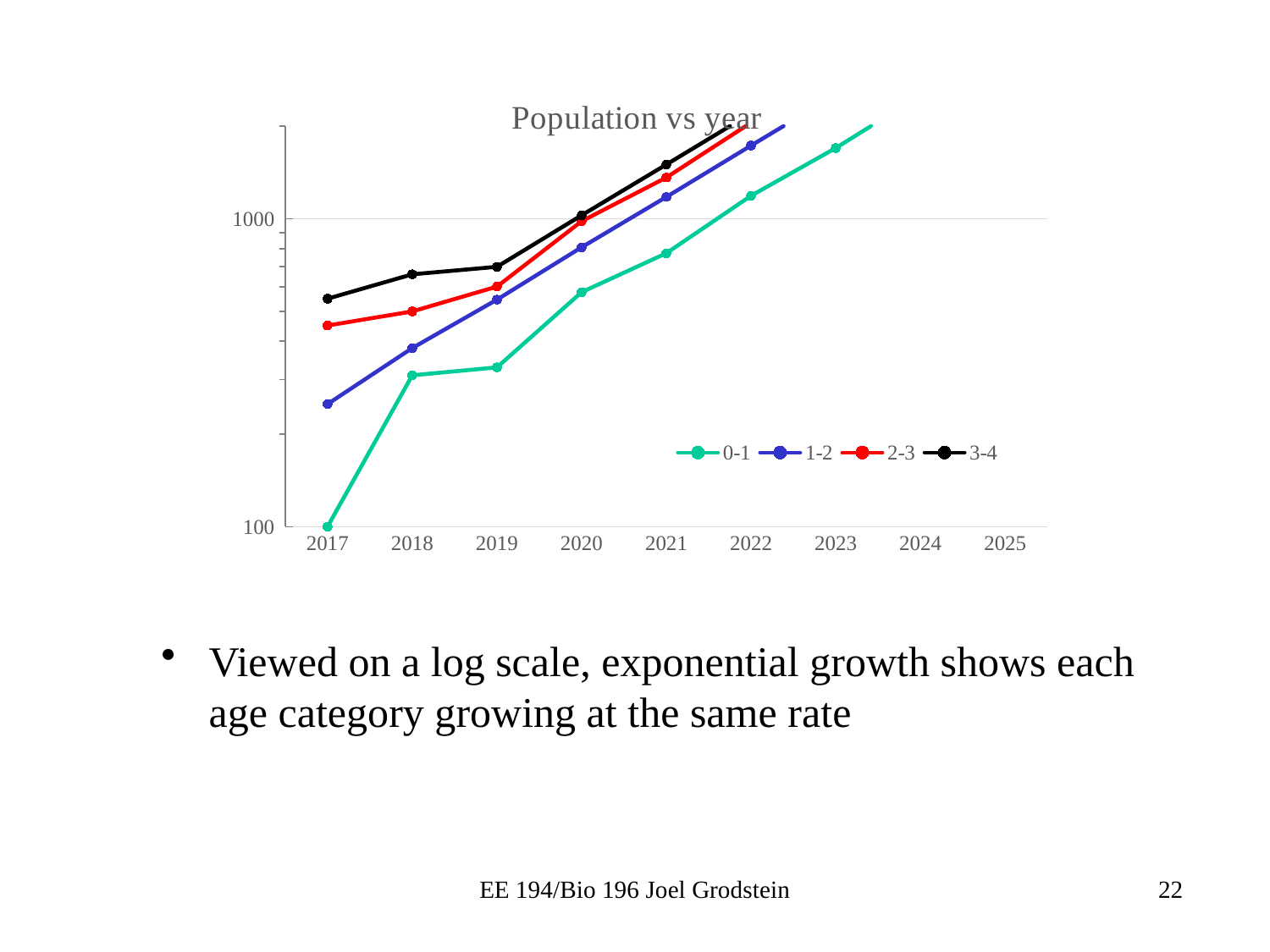
What is the title of the chart? Population vs year Is the value for the 3-4 series in 2021 greater or less than 1000? greater Which is larger in 2018, the 2-3 series or the 1-2 series? 2-3 Is the value for the 1-2 series in 2017 greater or less than 100? greater How many year labels are shown on the x axis? 9 Which series has the highest value in 2017? 3-4 How many series does the legend list? 4 What is the value of the 0-1 series in 2017? 100 Do the values of the 1-2 series rise or fall from 2017 to 2022? rise Which series has the lowest value in 2017? 0-1 What type of chart is shown on the slide? line chart Is the value for the 0-1 series in 2021 greater or less than 1000? less